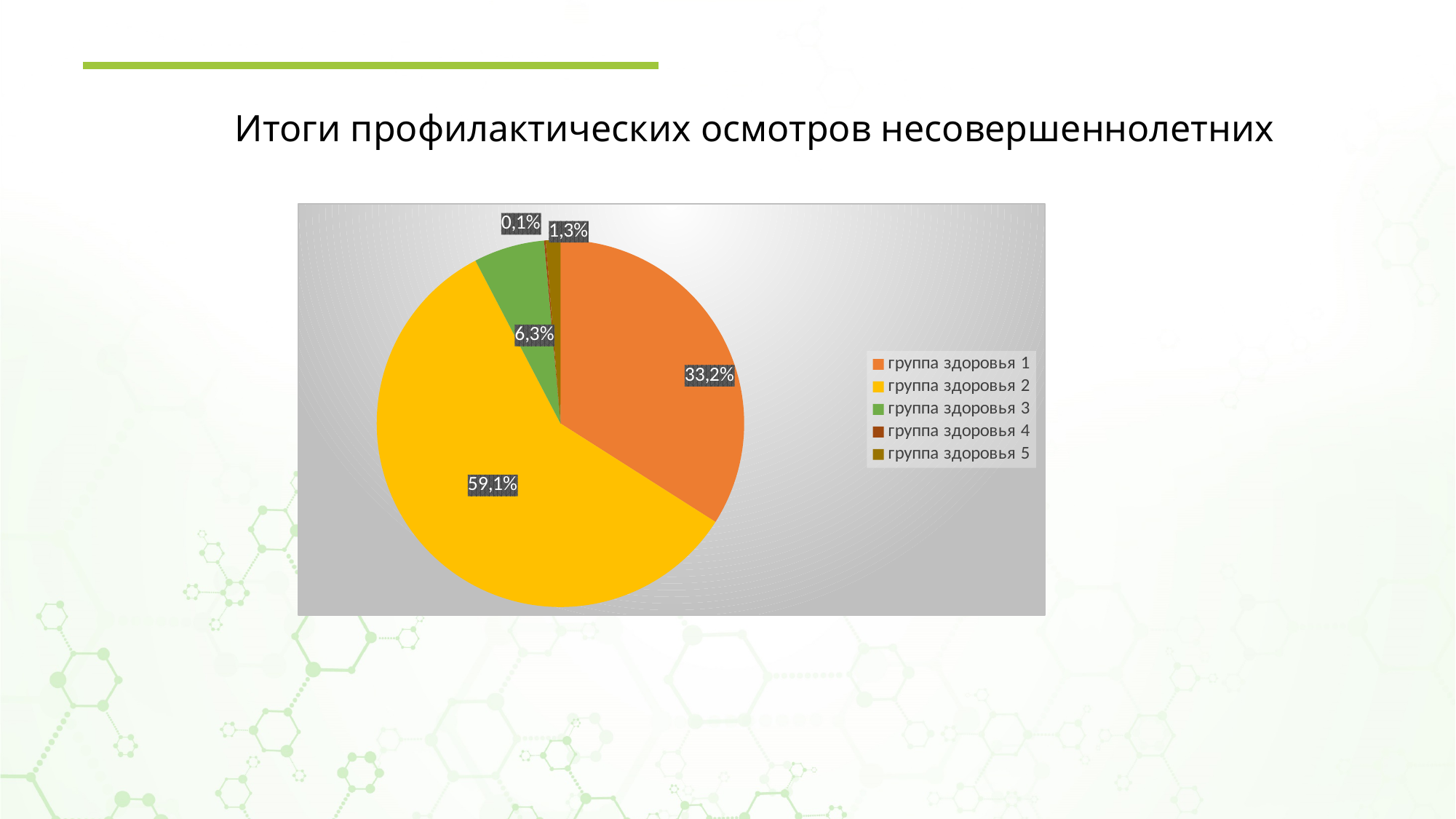
Which health group has the largest slice of the pie? группа здоровья 2 What is the difference between the values for группа здоровья 2 and группа здоровья 1? 25,9% What is the value for группа здоровья 5? 1,3% What is the value for группа здоровья 3? 6,3% How many entries does the legend list? 5 What kind of chart is shown on the slide? pie chart What is the value for группа здоровья 2? 59,1% Which health group has the smallest slice of the pie? группа здоровья 4 What is the title of the slide containing the chart? Итоги профилактических осмотров несовершеннолетних How many slices does the pie chart have? 5 What is the value for группа здоровья 1? 33,2% Which is larger, the value for группа здоровья 3 or the value for группа здоровья 5? группа здоровья 3